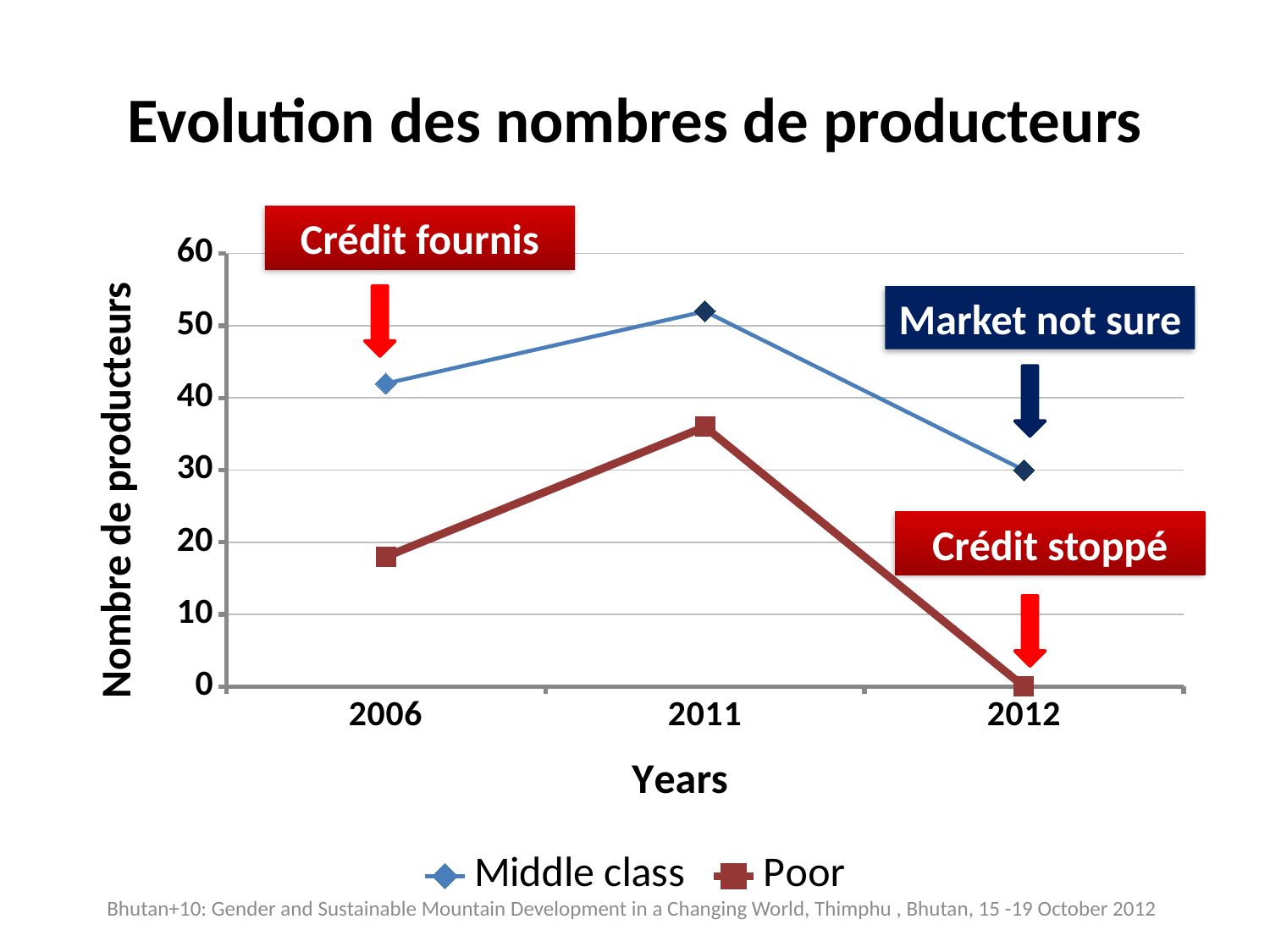
In which year is the Poor series at its highest? 2011 What is the value for Middle class in 2012? 30 Does the Middle class series rise or fall between 2011 and 2012? Fall Which series has the larger value in 2011, Middle class or Poor? Middle class Is the value for Middle class in 2006 greater or less than 40? greater Is the value for Poor in 2011 greater or less than 30? greater How many series does the legend list? 2 Is the value for Poor in 2006 greater or less than 20? less What is the value for Poor in 2012? 0 What kind of chart is shown on the slide? Line chart How many years are plotted on the x axis? 3